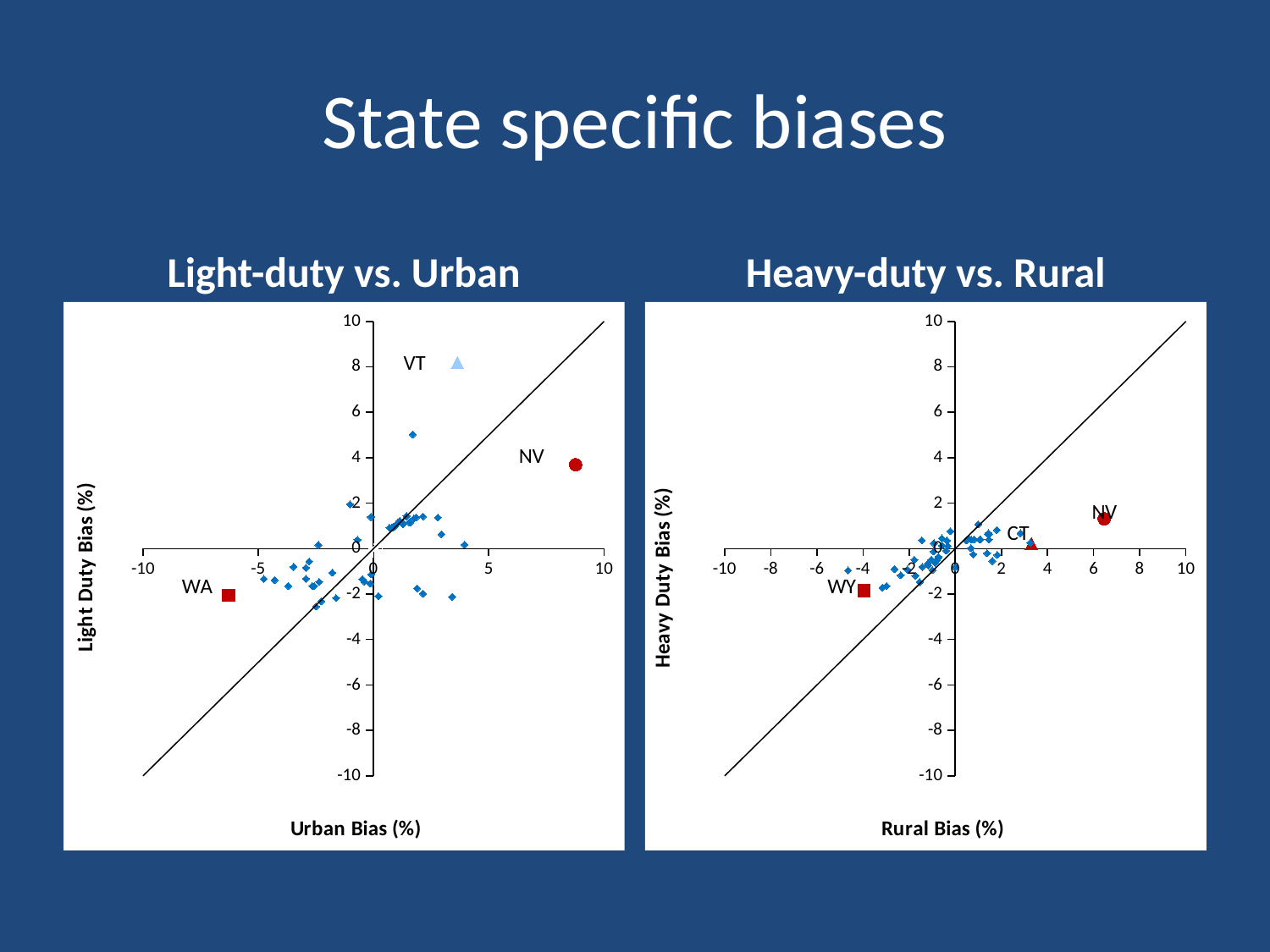
In the Light-duty vs. Urban chart, which labeled state has the larger Urban Bias, NV or WA? NV In the Heavy-duty vs. Rural chart, is the Rural Bias value for WY greater or less than -2? less In the Heavy-duty vs. Rural chart, is the Rural Bias value for CT greater or less than 2? greater In the Light-duty vs. Urban chart, is the Light Duty Bias value for VT greater or less than 6? greater What is the x-axis title of the Heavy-duty vs. Rural chart? Rural Bias (%) How many states are labeled by name in the Heavy-duty vs. Rural chart? 3 In the Heavy-duty vs. Rural chart, which labeled state has the larger Rural Bias, NV or WY? NV What kind of chart is the Light-duty vs. Urban chart? scatter chart In the Light-duty vs. Urban chart, which labeled state has the higher Light Duty Bias, VT or NV? VT